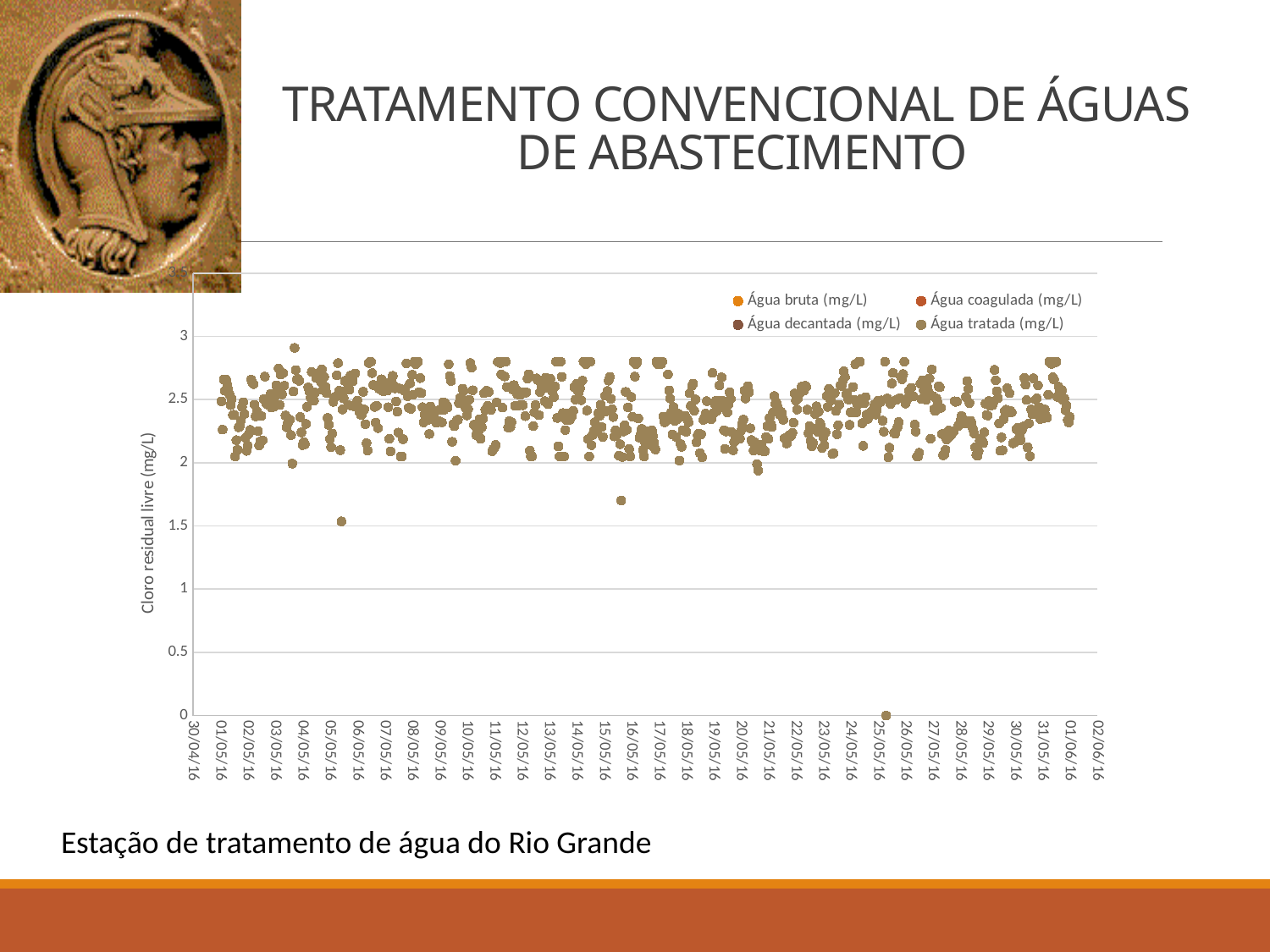
What kind of chart is shown on the slide? scatter chart Is the lowest plotted point on the chart, near 25/05/16, greater or less than 0.5? less Which series is listed last in the chart legend? Água tratada (mg/L) Is the isolated low point plotted near 05/05/16 greater or less than 2? less What is the label of the vertical axis of the chart? Cloro residual livre (mg/L) Are the bulk of the plotted points greater or less than 2? greater Which of the two isolated low points is lower: the one near 05/05/16 or the one near 15/05/16? the one near 05/05/16 How many series does the chart legend list? 4 Do the plotted values show a clear rising or falling trend across the dates on the x axis, or do they stay roughly level? roughly level